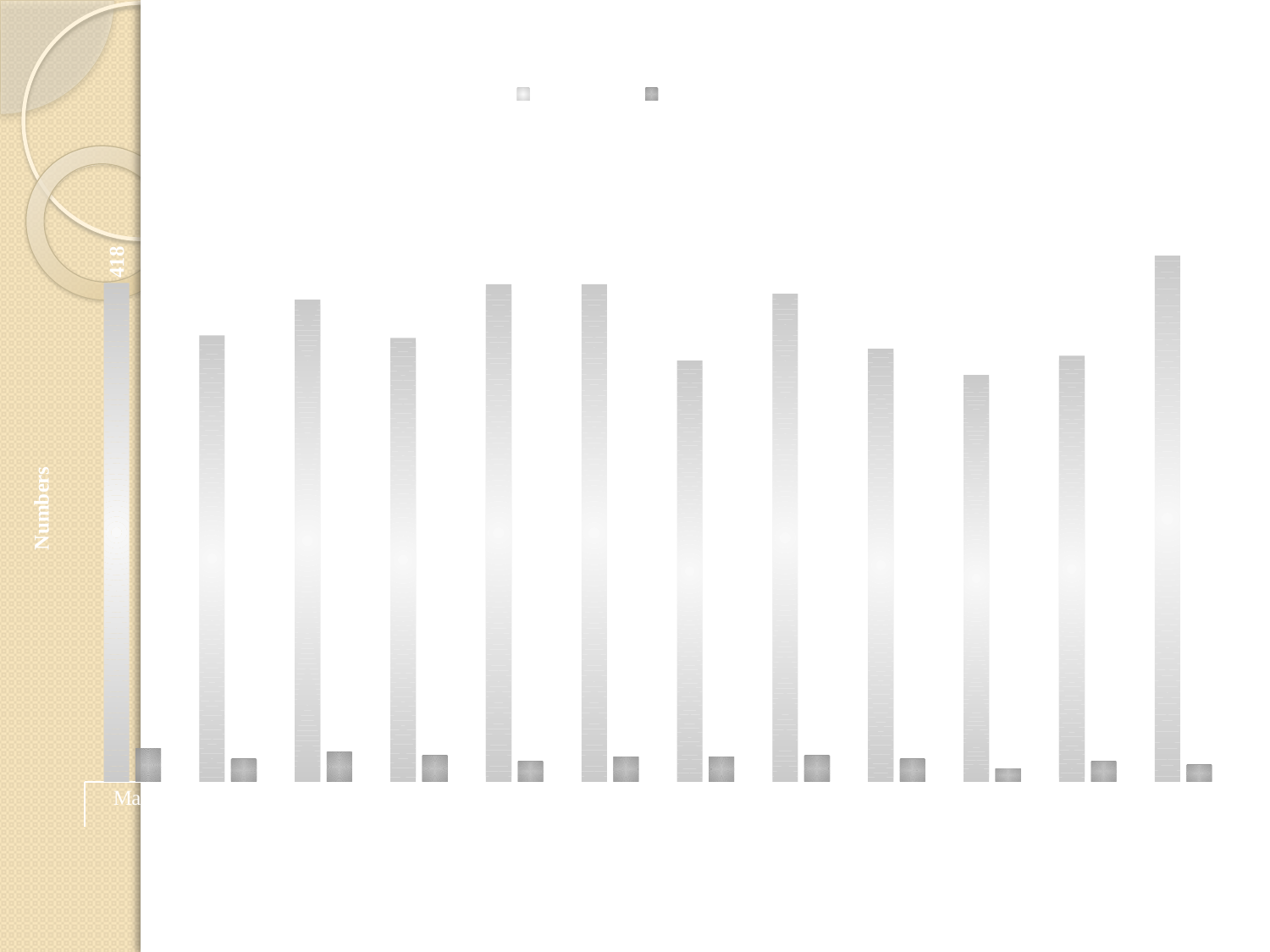
What kind of chart is shown on the slide? bar chart Which category has the tallest light-coloured bar: the first one on the left or the last one on the right? the last one on the right How many series does the chart's legend list? 2 What data label is printed above the first light-coloured bar on the left? 418 How many categories (pairs of bars) are plotted along the x axis? 12 What is the title of the vertical axis? Numbers In each category, which series has the taller bar: the light-coloured series or the dark-coloured series? the light-coloured series